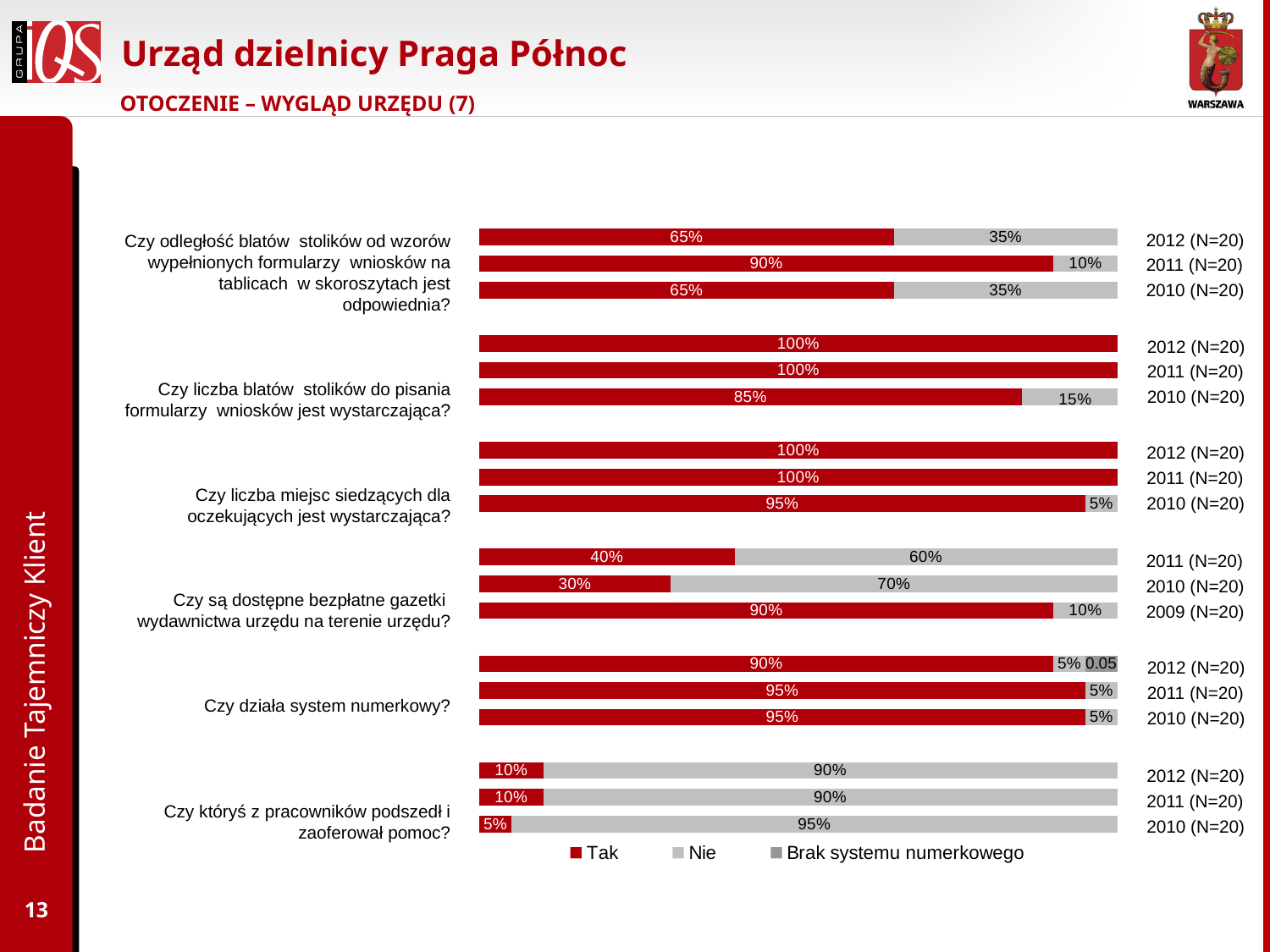
For "Czy są dostępne bezpłatne gazetki wydawnictwa urzędu na terenie urzędu?", which year has the highest "Tak" share? 2009 How many series does the legend list? 3 For "Czy są dostępne bezpłatne gazetki wydawnictwa urzędu na terenie urzędu?", which year has the larger "Tak" share, 2011 or 2010? 2011 How many years are shown for "Czy działa system numerkowy?"? 3 What kind of chart is shown on the slide? Stacked bar chart What is the "Nie" share for "Czy odległość blatów stolików od wzorów wypełnionych formularzy wniosków na tablicach w skoroszytach jest odpowiednia?" in 2012 (N=20)? 35% What percentage answered "Tak" for "Czy działa system numerkowy?" in 2012 (N=20)? 90% What is the "Tak" value for "Czy któryś z pracowników podszedł i zaoferował pomoc?" in 2010 (N=20)? 5% What is the "Tak" value for "Czy liczba blatów stolików do pisania formularzy wniosków jest wystarczająca?" in 2010 (N=20)? 85% What is the "Nie" share for "Czy są dostępne bezpłatne gazetki wydawnictwa urzędu na terenie urzędu?" in 2010 (N=20)? 70% Which legend entry is shown in red? Tak For the question about the distance of table tops from sample forms ("Czy odległość blatów stolików..."), how much higher is the "Tak" share in 2011 than in 2012? 25 percentage points